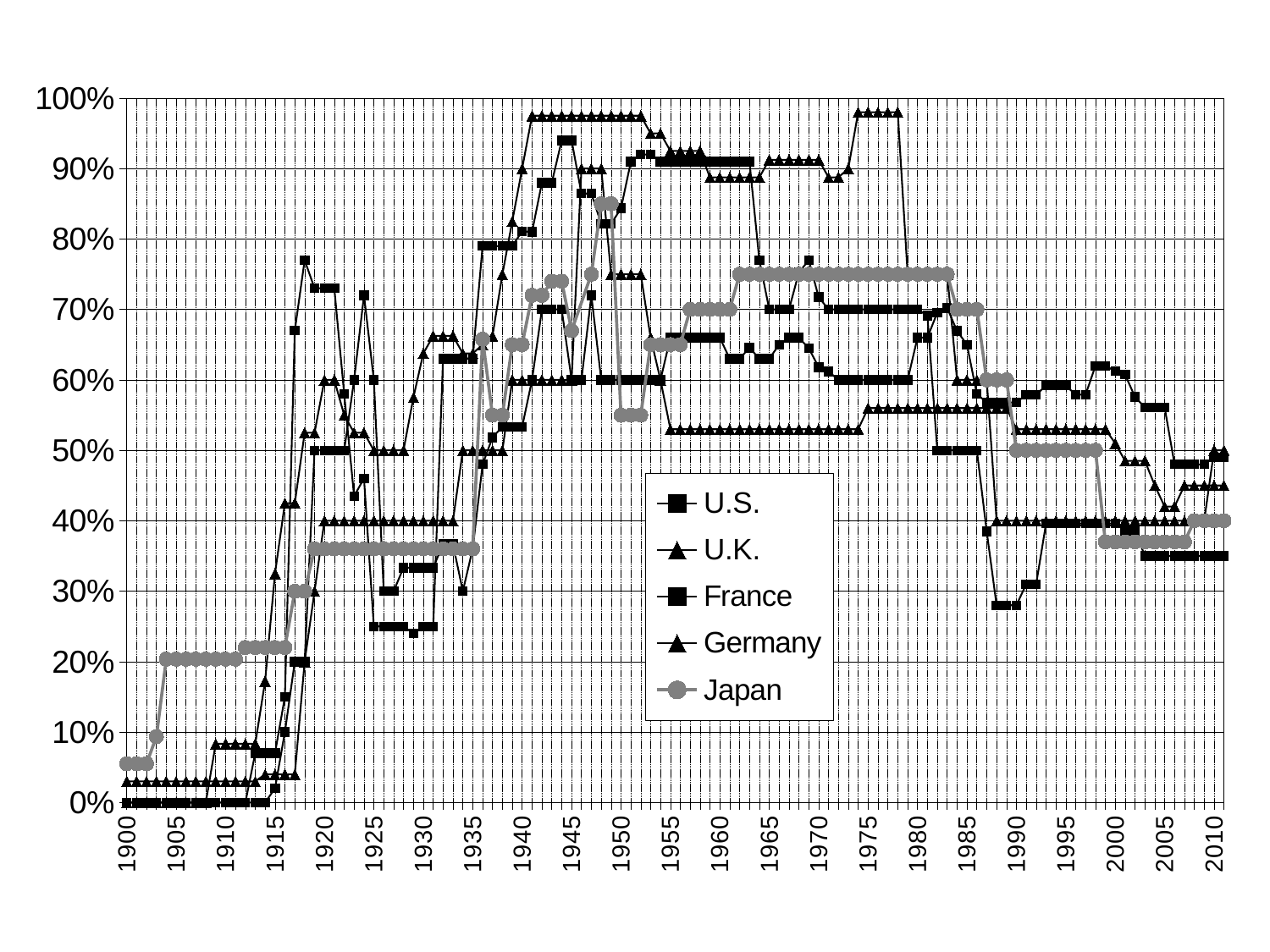
Is the value for Japan in 1900 greater or less than 10%? less Is the value for Japan in 1925 greater or less than 30%? greater Is the value for Japan in 1905 greater or less than 30%? less How many series does the legend list? 5 Which series are listed in the legend? U.S., U.K., France, Germany, Japan What kind of chart is shown on the slide? line chart Does the Japan series rise or fall between 1985 and 2010? fall What marker is used for the Japan series? gray circles Which is larger for Japan, the value in 1905 or the value in 1975? 1975